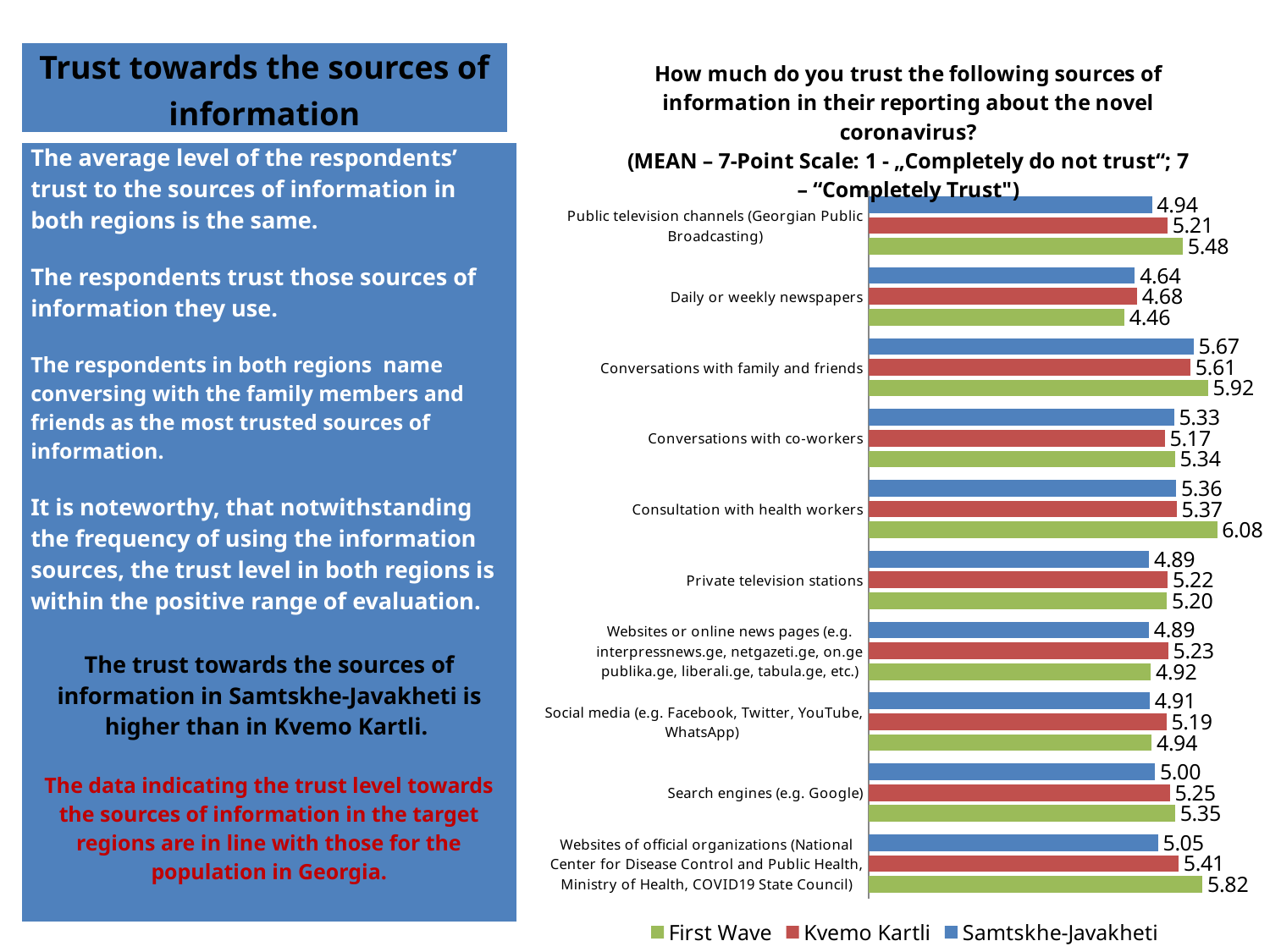
What is the difference between the Kvemo Kartli and Samtskhe-Javakheti values for Search engines (e.g. Google)? 0.25 Which series is shown in green in the chart? First Wave Which source of information has the lowest First Wave value? Daily or weekly newspapers For Private television stations, which is larger: the Kvemo Kartli value or the Samtskhe-Javakheti value? Kvemo Kartli What is the difference between the First Wave and Samtskhe-Javakheti values for Public television channels? 0.54 What kind of chart is shown on the slide? Bar chart How many sources of information (categories) are plotted in the chart? 10 What is the Samtskhe-Javakheti value for Conversations with family and friends? 5.67 What is the Kvemo Kartli value for Websites of official organizations? 5.41 What is the First Wave value for Consultation with health workers? 6.08 How many series does the legend list? 3 Which source of information has the highest Samtskhe-Javakheti value? Conversations with family and friends